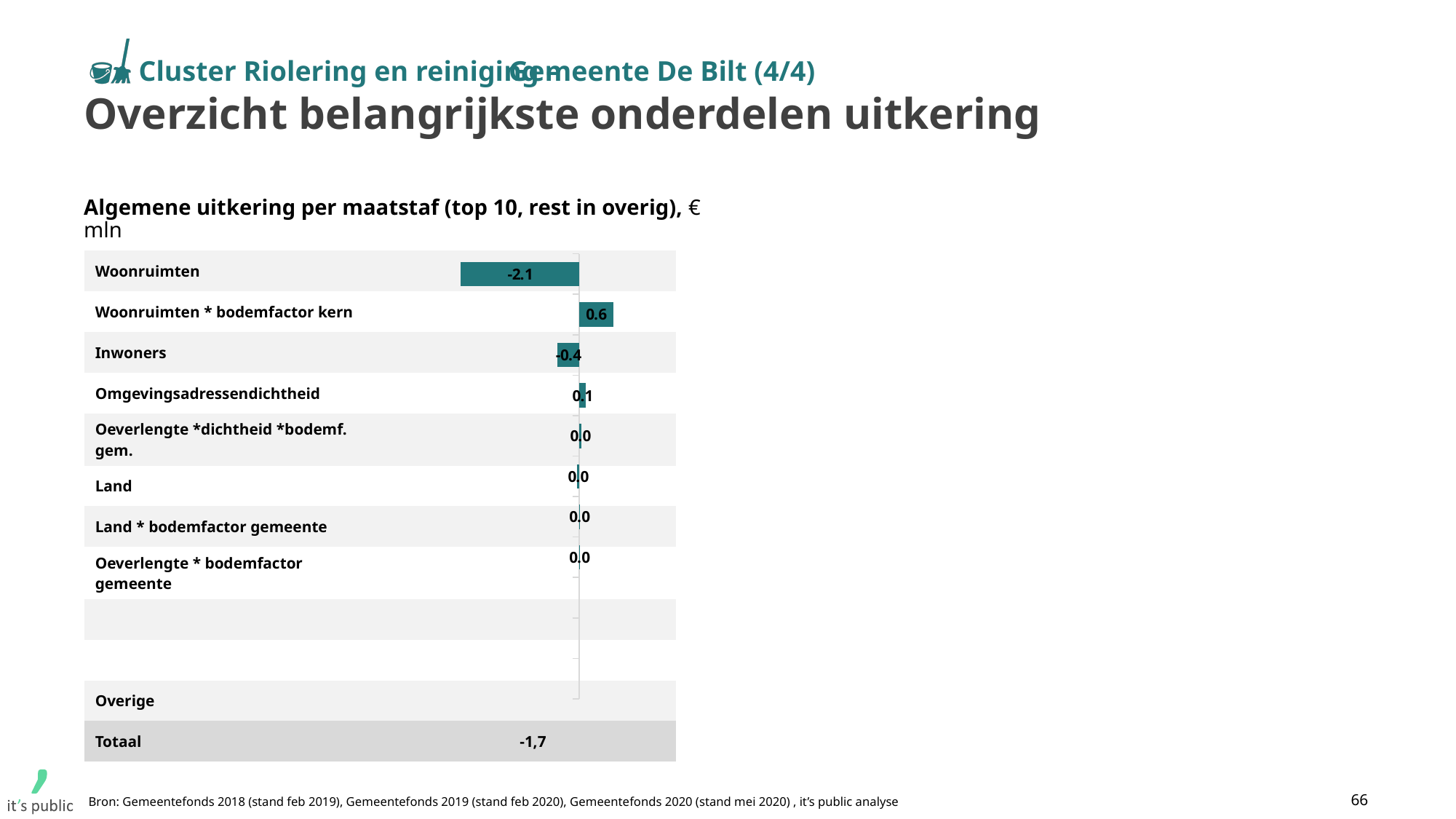
What is the value for Woonruimten? -2.1 What is the difference between the values for Woonruimten * bodemfactor kern and Inwoners? 1.0 What is the value for Omgevingsadressendichtheid? 0.1 What kind of chart is shown on the slide? Bar chart Which is larger, the value for Omgevingsadressendichtheid or the value for Inwoners? Omgevingsadressendichtheid What is the value for Woonruimten * bodemfactor kern? 0.6 What is the title of the chart? Algemene uitkering per maatstaf (top 10, rest in overig), € mln What is the value shown for Totaal? -1,7 What is the value for Inwoners? -0.4 Which category has the highest value? Woonruimten * bodemfactor kern Which category has the lowest (most negative) value? Woonruimten How many categories show a value of 0.0? 4